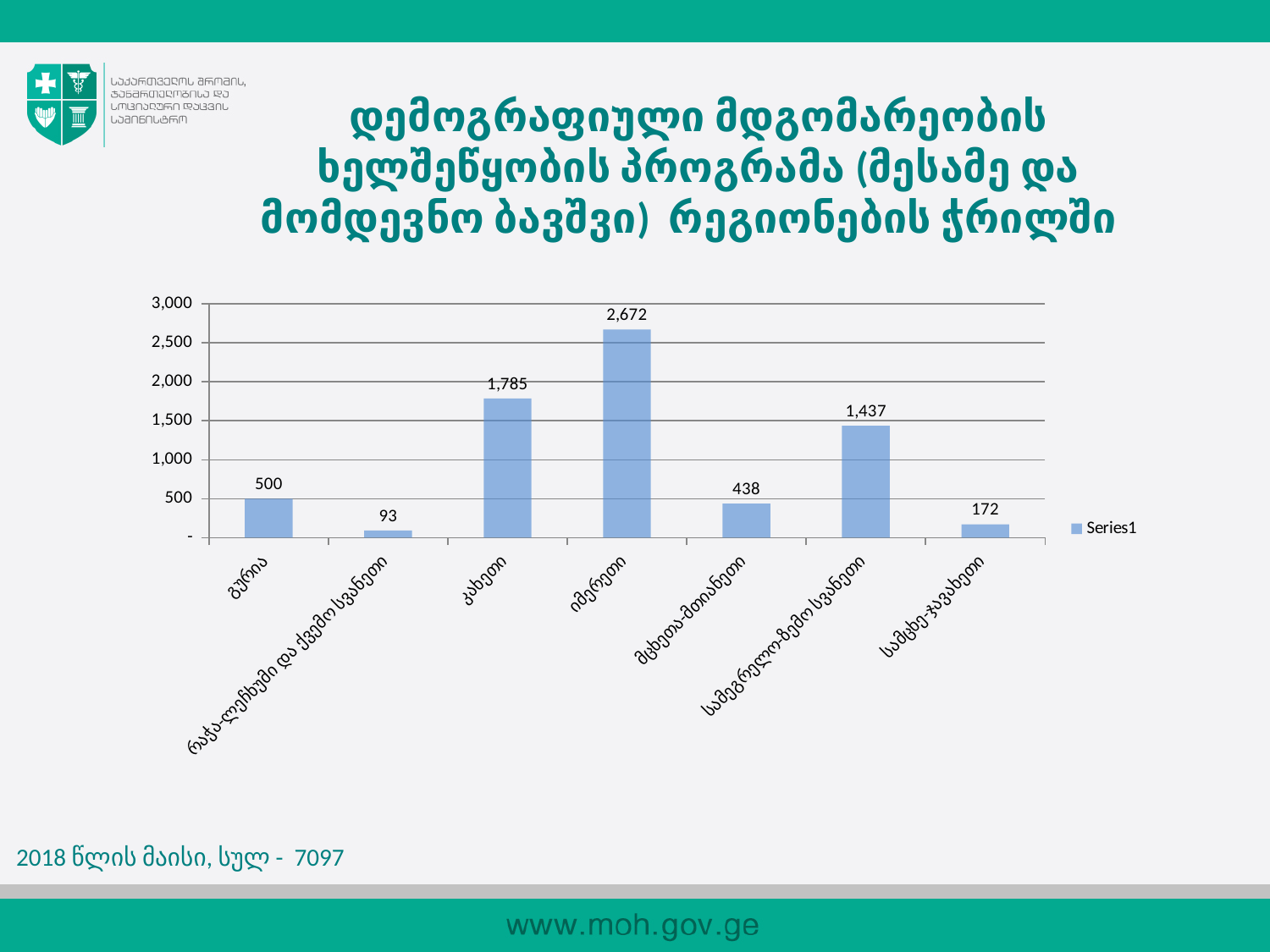
Is the value for კახეთი greater or less than 1,500? greater How many series does the legend list? 1 What kind of chart is shown on the slide? bar chart What is the value for იმერეთი? 2,672 What is the value for რაჭა-ლეჩხუმი და ქვემო სვანეთი? 93 How many regions are shown on the chart? 7 What is the value for სამეგრელო-ზემო სვანეთი? 1,437 What is the value for გურია? 500 Which is larger, the value for მცხეთა-მთიანეთი or the value for სამცხე-ჯავახეთი? მცხეთა-მთიანეთი Which region has the lowest value? რაჭა-ლეჩხუმი და ქვემო სვანეთი What is the difference between the values for იმერეთი and კახეთი? 887 Which region has the highest value? იმერეთი